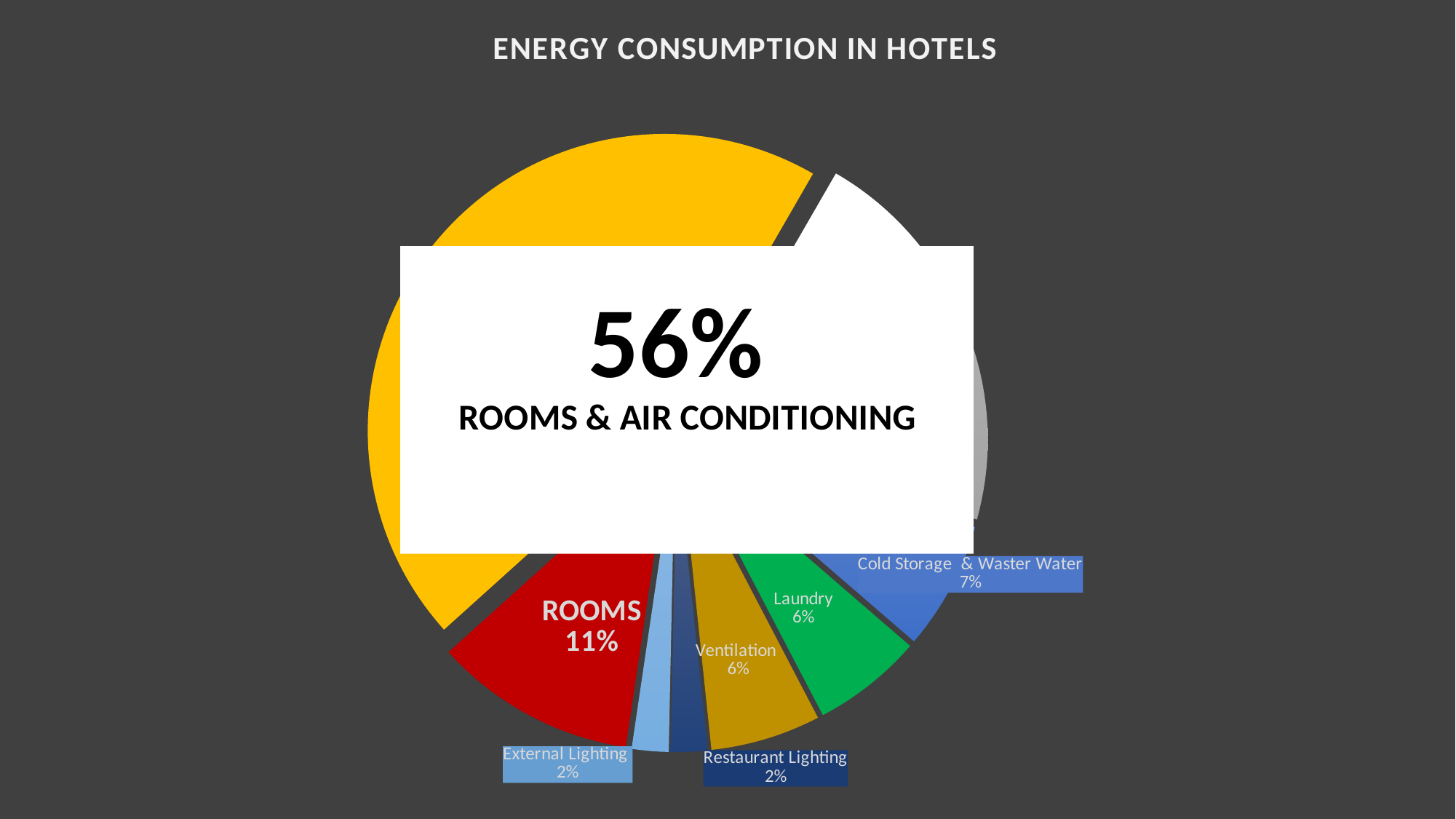
Which is larger, the share for Laundry or the share for Restaurant Lighting? Laundry What percentage is shown for Rooms? 11% What percentage is shown for External Lighting? 2% Which is larger, the share for Rooms or the share for Cold Storage & Waster Water? Rooms What percentage is shown in the white box for Rooms & Air Conditioning? 56% What percentage is shown for Laundry? 6% What kind of chart is shown on the slide? pie chart What percentage is shown for Ventilation? 6% What percentage is shown for Cold Storage & Waster Water? 7% What colour is the Rooms slice? red What is the title of the chart? ENERGY CONSUMPTION IN HOTELS What is the difference between the Rooms share and the Cold Storage & Waster Water share? 4%